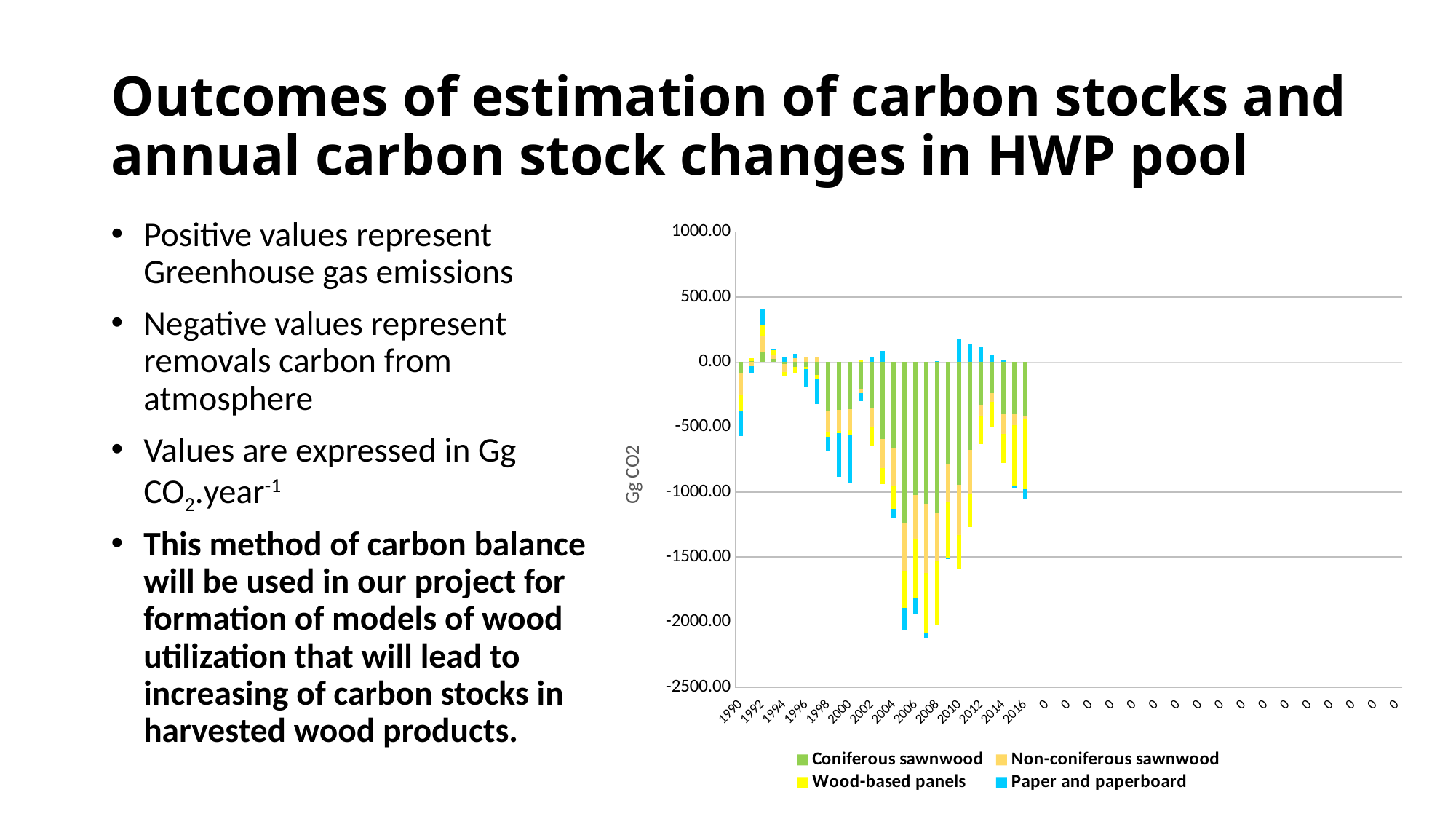
Which year's stacked bar extends further below zero, 1994 or 2004? 2004 Is the top of the stacked bar for 1992 greater or less than 500? less What kind of chart is shown on the slide? Stacked bar chart Which year's stacked bar extends further below zero, 2008 or 2016? 2008 How many series does the chart legend list? 4 What is the label on the vertical axis of the chart? Gg CO2 Is the bottom of the lowest stacked bar on the chart greater or less than -2000? less Is the bottom of the stacked bar for 2000 greater or less than -1000? greater Which series in the legend is shown in green? Coniferous sawnwood From 1996 to 2006, do the stacked bars become more negative or less negative? more negative From 2008 to 2016, do the stacked bars become more negative or less negative? less negative